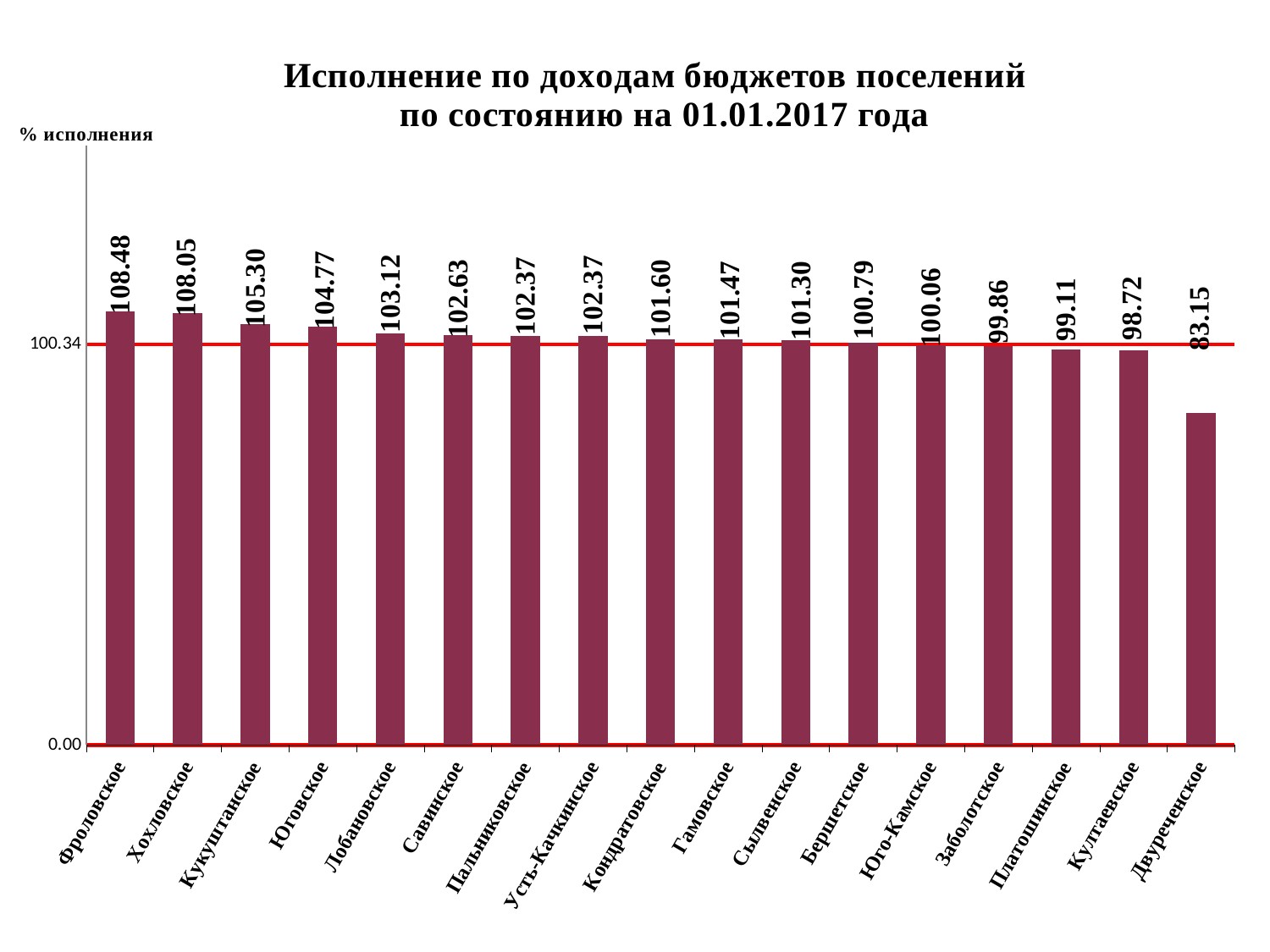
Which is larger, the value for Кукуштанское or the value for Лобановское? Кукуштанское What value is marked by the horizontal red line on the chart? 100.34 What is the difference between the values for Фроловское and Хохловское? 0.43 What kind of chart is this? bar chart Do the values generally rise or fall from left to right along the x axis? fall What is the value for Фроловское? 108.48 How many settlements are shown on the chart? 17 What is the difference between the values for Култаевское and Двуреченское? 15.57 What is the value for Юго-Камское? 100.06 What is the value for Двуреченское? 83.15 Which settlement has the lowest value? Двуреченское Which settlement has the highest value? Фроловское